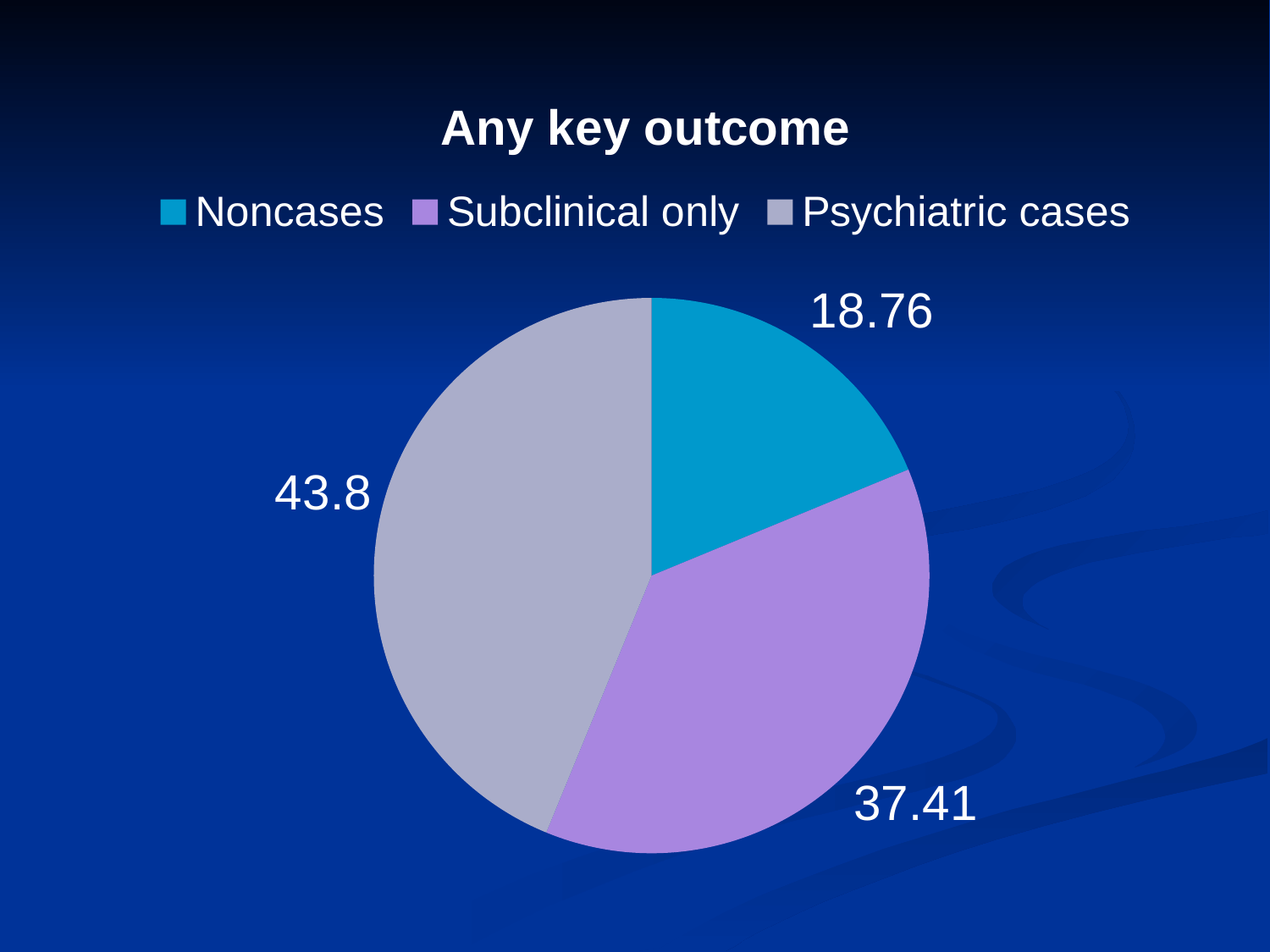
How many categories does the pie chart have? 3 What is the title of the chart? Any key outcome Which category has the largest slice? Psychiatric cases What type of chart is shown on the slide? pie chart What is the value for Subclinical only? 37.41 How many entries does the legend list? 3 Which is larger, the value for Subclinical only or the value for Noncases? Subclinical only What is the value for Psychiatric cases? 43.8 What is the difference between the values for Psychiatric cases and Subclinical only? 6.39 Which category has the smallest slice? Noncases What is the difference between the values for Subclinical only and Noncases? 18.65 What is the value for Noncases? 18.76